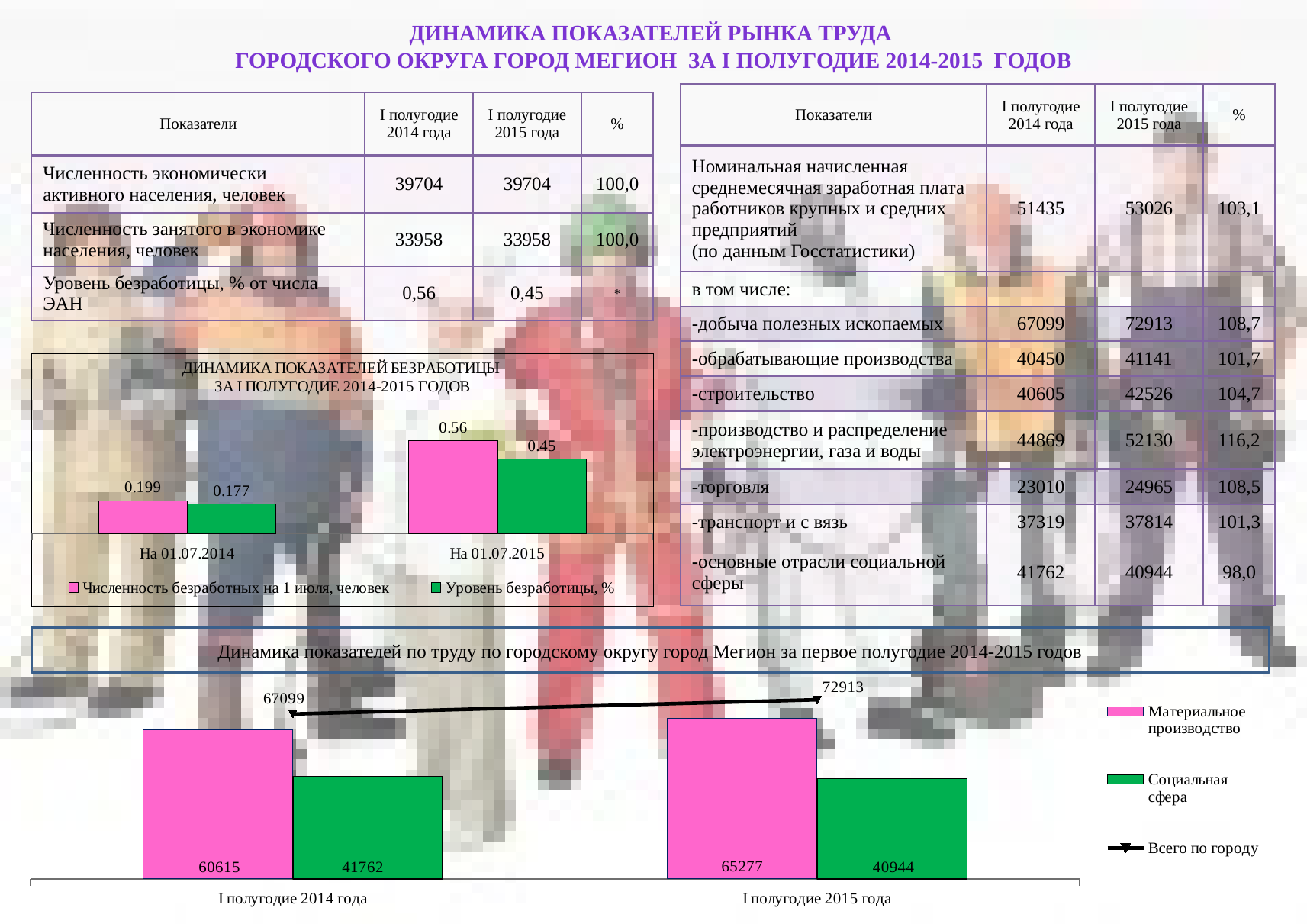
In the bottom chart 'Динамика показателей по труду по городскому округу город Мегион', which is larger for 'I полугодие 2015 года': 'Материальное производство' or 'Социальная сфера'? Материальное производство In the chart 'Динамика показателей безработицы за I полугодие 2014-2015 годов', does the 'Уровень безработицы, %' series rise or fall from 'На 01.07.2014' to 'На 01.07.2015'? rise In the bottom chart 'Динамика показателей по труду по городскому округу город Мегион', what is the difference between 'Материальное производство' and 'Социальная сфера' for 'I полугодие 2014 года'? 18853 In the chart 'Динамика показателей безработицы за I полугодие 2014-2015 годов', what is the value of 'Уровень безработицы, %' for 'На 01.07.2014'? 0.177 In the bottom chart 'Динамика показателей по труду по городскому округу город Мегион', how many series does the legend list? 3 In the bottom chart 'Динамика показателей по труду по городскому округу город Мегион', what is the value of 'Материальное производство' for 'I полугодие 2015 года'? 65277 What kind of chart is the bottom chart 'Динамика показателей по труду по городскому округу город Мегион'? bar chart with a line In the chart 'Динамика показателей безработицы за I полугодие 2014-2015 годов', how many series does the legend list? 2 In the chart 'Динамика показателей безработицы за I полугодие 2014-2015 годов', which colour represents 'Уровень безработицы, %'? green In the bottom chart 'Динамика показателей по труду по городскому округу город Мегион', what is the value of 'Всего по городу' for 'I полугодие 2015 года'? 72913 In the bottom chart 'Динамика показателей по труду по городскому округу город Мегион', what is the value of 'Социальная сфера' for 'I полугодие 2014 года'? 41762 In the chart 'Динамика показателей безработицы за I полугодие 2014-2015 годов', what is the value of 'Численность безработных на 1 июля, человек' for 'На 01.07.2015'? 0.56